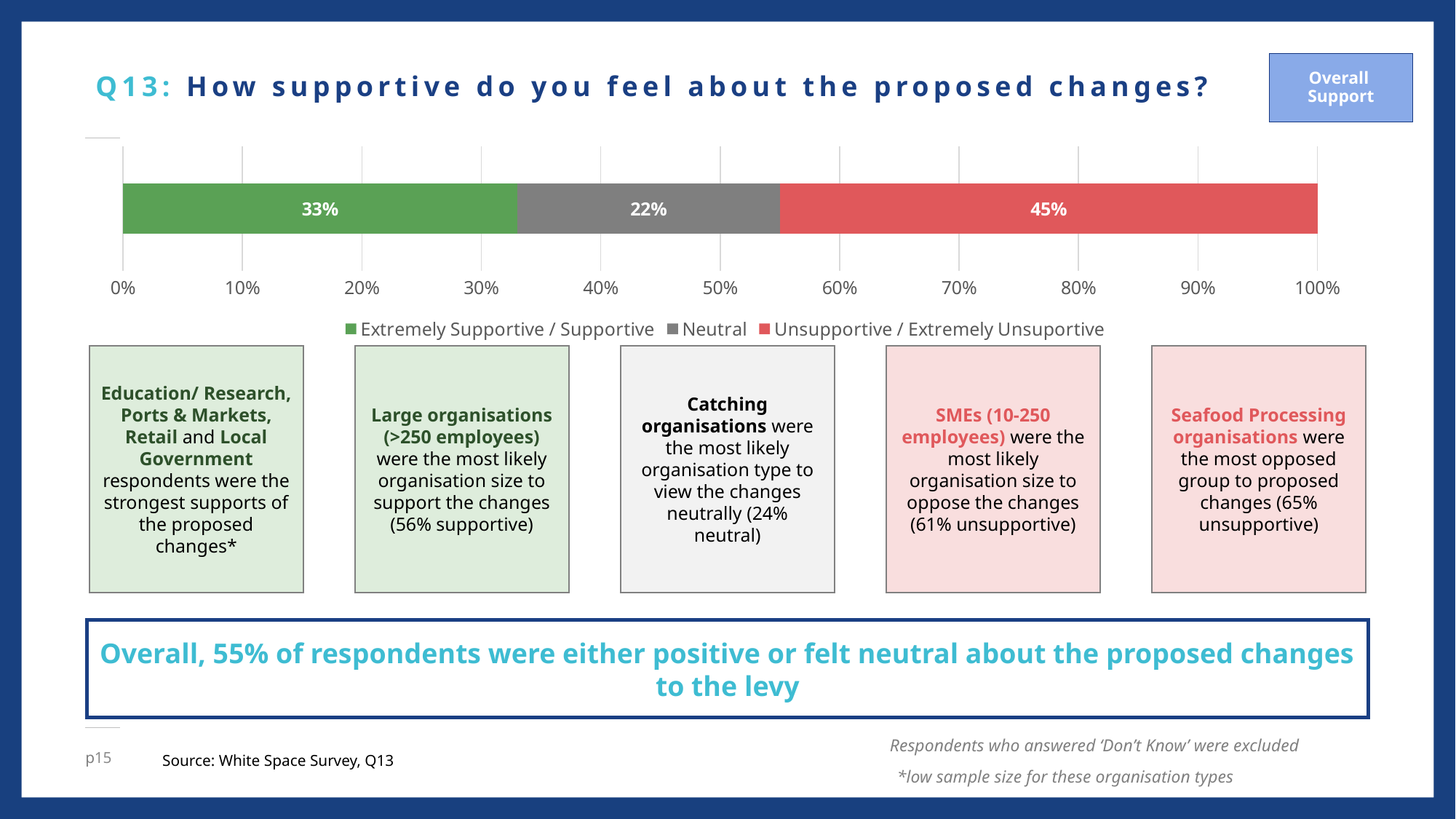
Which is larger, the Extremely Supportive / Supportive share or the Neutral share? Extremely Supportive / Supportive Which response category has the smallest share of respondents? Neutral What percentage of respondents were Neutral? 22% Is the Unsupportive / Extremely Unsupportive share greater or less than 40%? greater What percentage of respondents were Unsupportive / Extremely Unsupportive? 45% What kind of chart is shown on the slide? Stacked bar chart What is the difference between the Unsupportive / Extremely Unsupportive share and the Extremely Supportive / Supportive share? 12% Which response category has the largest share of respondents? Unsupportive / Extremely Unsupportive How many series does the legend list? 3 What percentage of respondents were Extremely Supportive / Supportive? 33% What is the combined share of Extremely Supportive / Supportive and Neutral respondents? 55% What colour represents the Neutral series in the chart? Grey